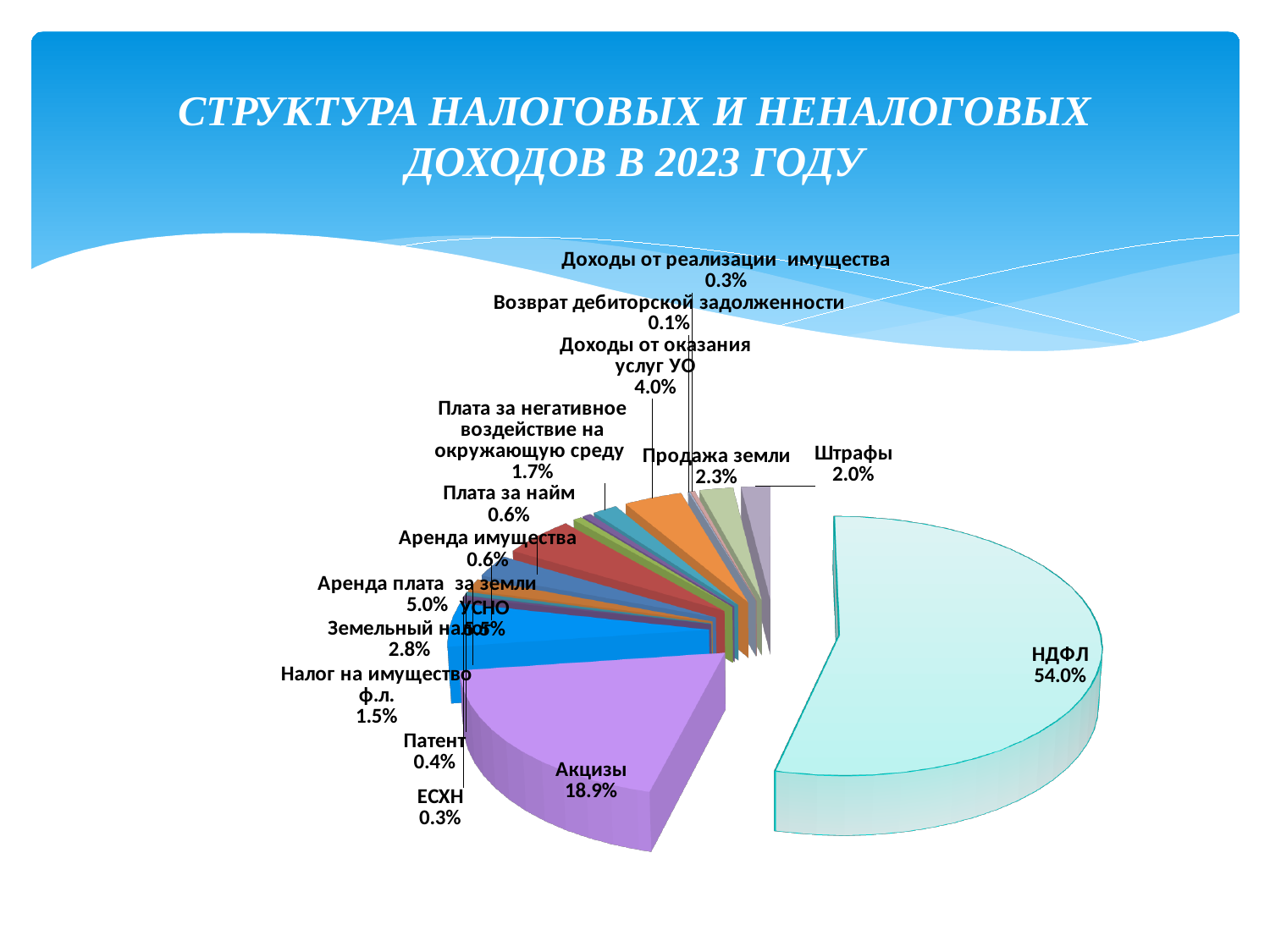
What is the value shown for Плата за негативное воздействие на окружающую среду? 1.7% What is the value shown for Штрафы? 2.0% What kind of chart is shown on the slide? pie chart Which is larger, the share for Продажа земли or the share for Штрафы? Продажа земли What is the difference between the shares of НДФЛ and Акцизы? 35.1% Which category has the smallest share of the pie? Возврат дебиторской задолженности Which category has the largest share of the pie? НДФЛ What share of the pie does НДФЛ account for? 54.0% What is the value shown for Аренда плата за земли? 5.0% What is the value shown for Акцизы? 18.9% What is the value shown for Доходы от оказания услуг УО? 4.0% What is the title of the slide? СТРУКТУРА НАЛОГОВЫХ И НЕНАЛОГОВЫХ ДОХОДОВ В 2023 ГОДУ